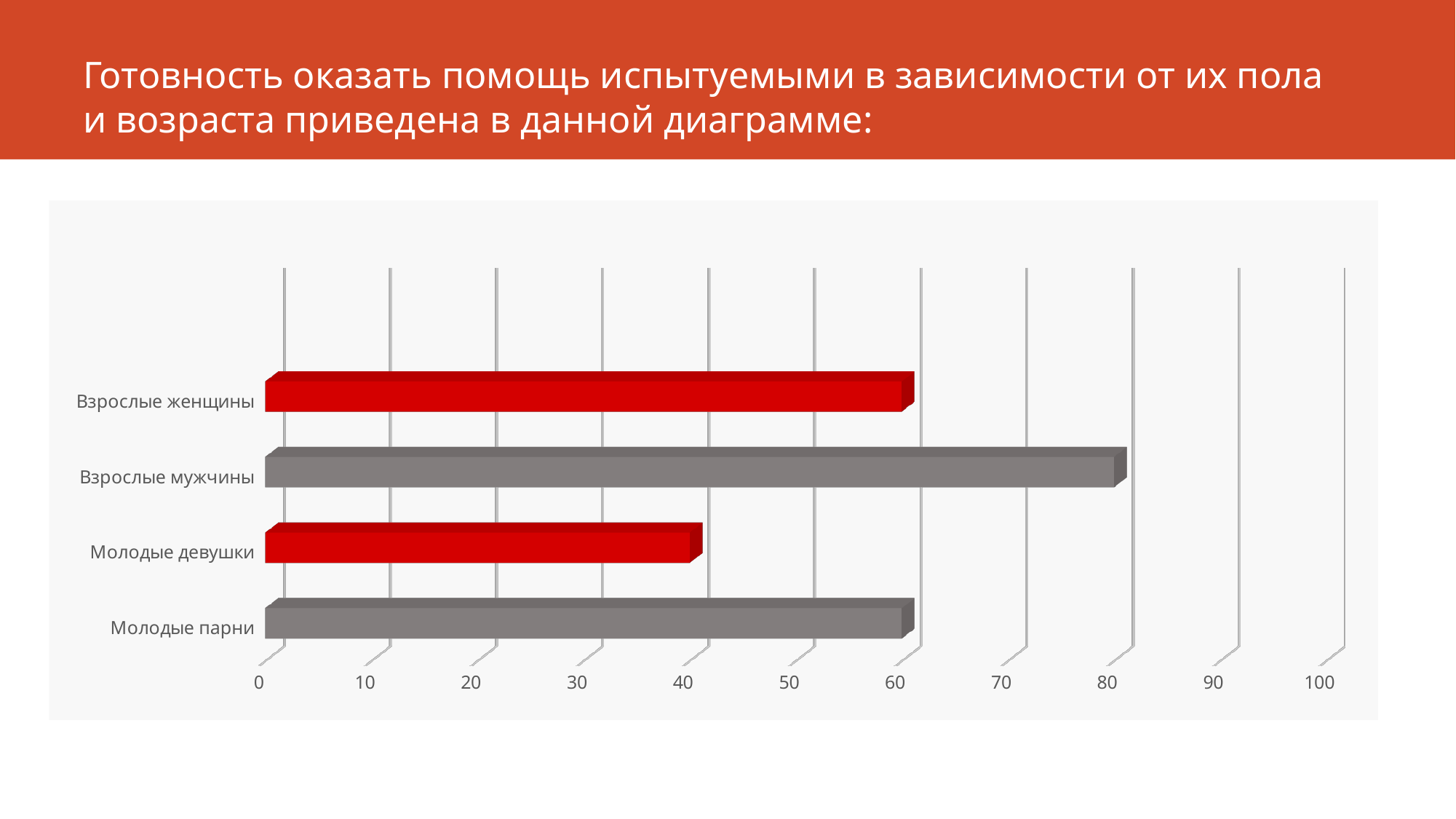
Which is larger, the value for Взрослые мужчины or the value for Молодые девушки? Взрослые мужчины Is the value for Взрослые женщины greater or less than 50? greater What colour are the bars for Взрослые женщины and Молодые девушки? red What kind of chart is shown on the slide? bar chart Which category has the lowest value in the chart? Молодые девушки What is the maximum value shown on the horizontal axis of the chart? 100 Is the value for Молодые девушки greater or less than 50? less How many categories are plotted in the chart? 4 Is the value for Взрослые мужчины greater or less than 70? greater Which category has the highest value in the chart? Взрослые мужчины Which is larger, the value for Взрослые женщины or the value for Молодые девушки? Взрослые женщины